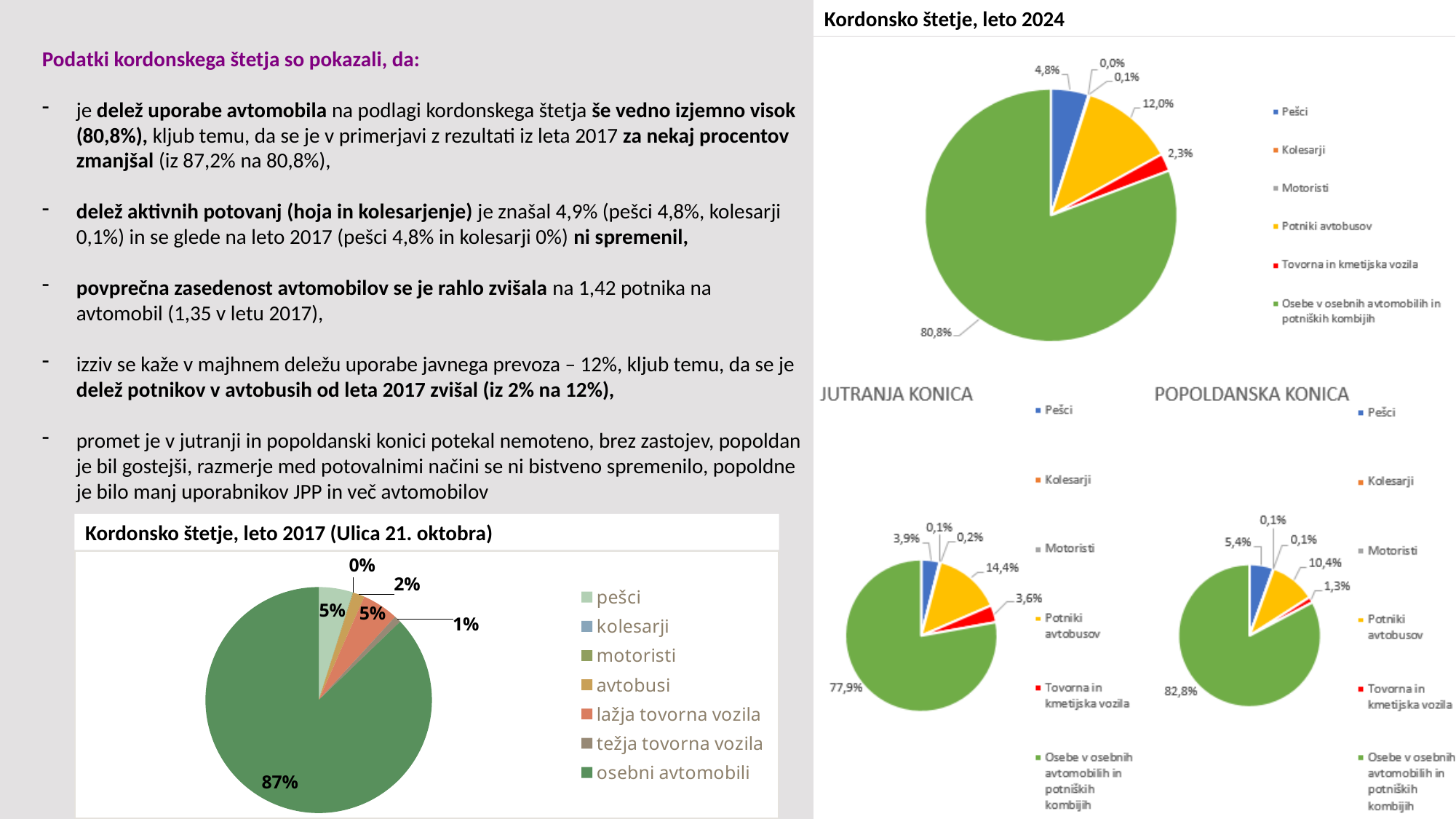
In the chart titled "Kordonsko štetje, leto 2017 (Ulica 21. oktobra)", how many categories does the legend list? 7 In the chart titled "Kordonsko štetje, leto 2024", which category has the largest slice? Osebe v osebnih avtomobilih in potniških kombijih What is the difference between the Potniki avtobusov share in the "JUTRANJA KONICA" chart (14,4%) and in the "POPOLDANSKA KONICA" chart (10,4%)? 4,0% In the chart titled "POPOLDANSKA KONICA", what share is labelled for Osebe v osebnih avtomobilih in potniških kombijih? 82,8% In the chart titled "Kordonsko štetje, leto 2024", what share is labelled for Potniki avtobusov? 12,0% In the chart titled "Kordonsko štetje, leto 2024", what share is labelled for Tovorna in kmetijska vozila? 2,3% In the chart titled "Kordonsko štetje, leto 2024", how many categories does the legend list? 6 What type of chart is "Kordonsko štetje, leto 2017 (Ulica 21. oktobra)"? pie chart In the chart titled "Kordonsko štetje, leto 2017 (Ulica 21. oktobra)", what share is labelled for osebni avtomobili? 87% In the chart titled "Kordonsko štetje, leto 2024", what share is labelled for Osebe v osebnih avtomobilih in potniških kombijih? 80,8% In the chart titled "JUTRANJA KONICA", what share is labelled for Potniki avtobusov? 14,4% Which is larger: the Pešci share in the "JUTRANJA KONICA" chart or the Pešci share in the "POPOLDANSKA KONICA" chart? POPOLDANSKA KONICA